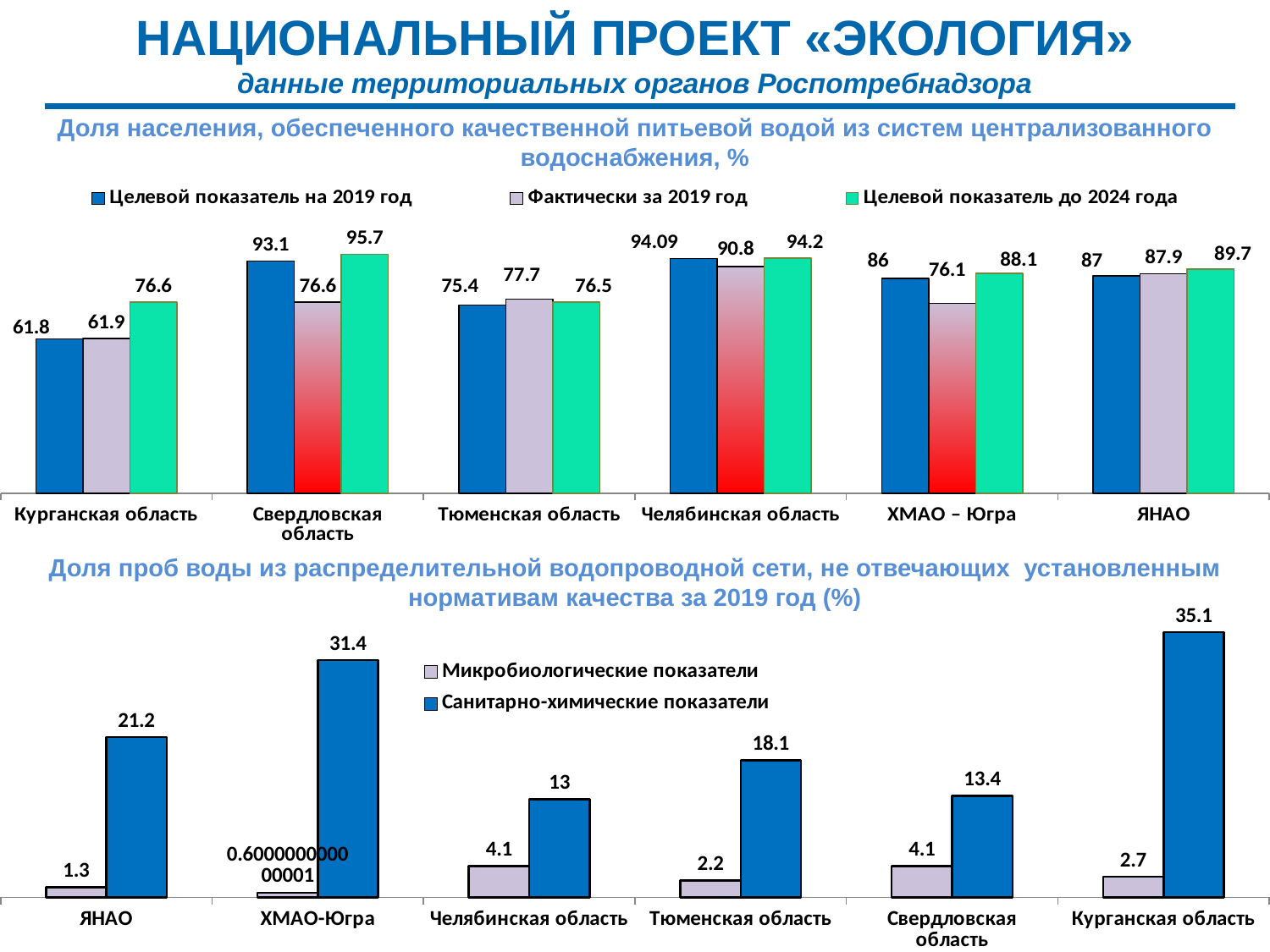
In the top chart, what is the difference between «Целевой показатель на 2019 год» and «Фактически за 2019 год» for Свердловская область? 16.5 What type of chart is the bottom chart? Bar chart In the bottom chart, which region has the lowest value for «Микробиологические показатели»? ХМАО-Югра In the bottom chart, which is larger: «Санитарно-химические показатели» for ЯНАО or for Челябинская область? ЯНАО In the bottom chart, what is the value of «Санитарно-химические показатели» for Тюменская область? 18.1 In the top chart, what is the value of «Целевой показатель до 2024 года» for ХМАО – Югра? 88.1 In the top chart, which region has the highest value for «Целевой показатель до 2024 года»? Свердловская область In the top chart, which region has the lowest value for «Целевой показатель на 2019 год»? Курганская область In the top chart, what is the value of «Фактически за 2019 год» for Свердловская область? 76.6 How many regions are shown on the x axis of the bottom chart? 6 In the bottom chart, which region has the highest value for «Санитарно-химические показатели»? Курганская область How many series does the legend of the top chart list? 3